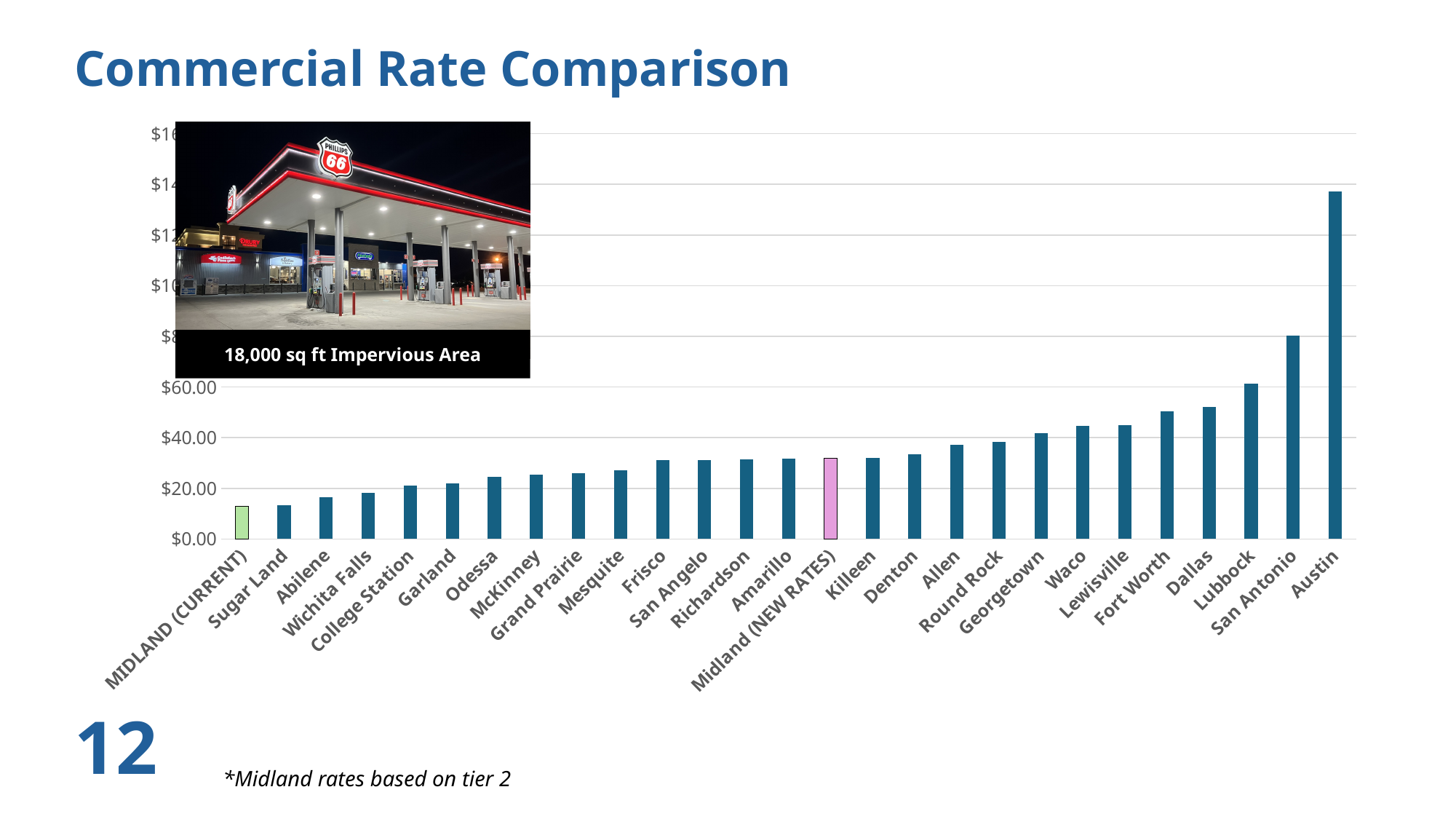
Which category's bar is coloured pink instead of blue? Midland (NEW RATES) Is the value for Austin greater or less than $120? greater Which category has the lowest value in the chart? MIDLAND (CURRENT) Do the values generally rise or fall moving from left to right along the x axis? rise Which category has the highest value in the chart? Austin What kind of chart is shown on the slide? Bar chart Is the value for Midland (NEW RATES) greater or less than $40.00? less Is the value for MIDLAND (CURRENT) greater or less than $20.00? less How many cities or categories are plotted on the x axis of the chart? 27 Which has the larger value, San Antonio or Dallas? San Antonio What is the title of the chart on the slide? Commercial Rate Comparison